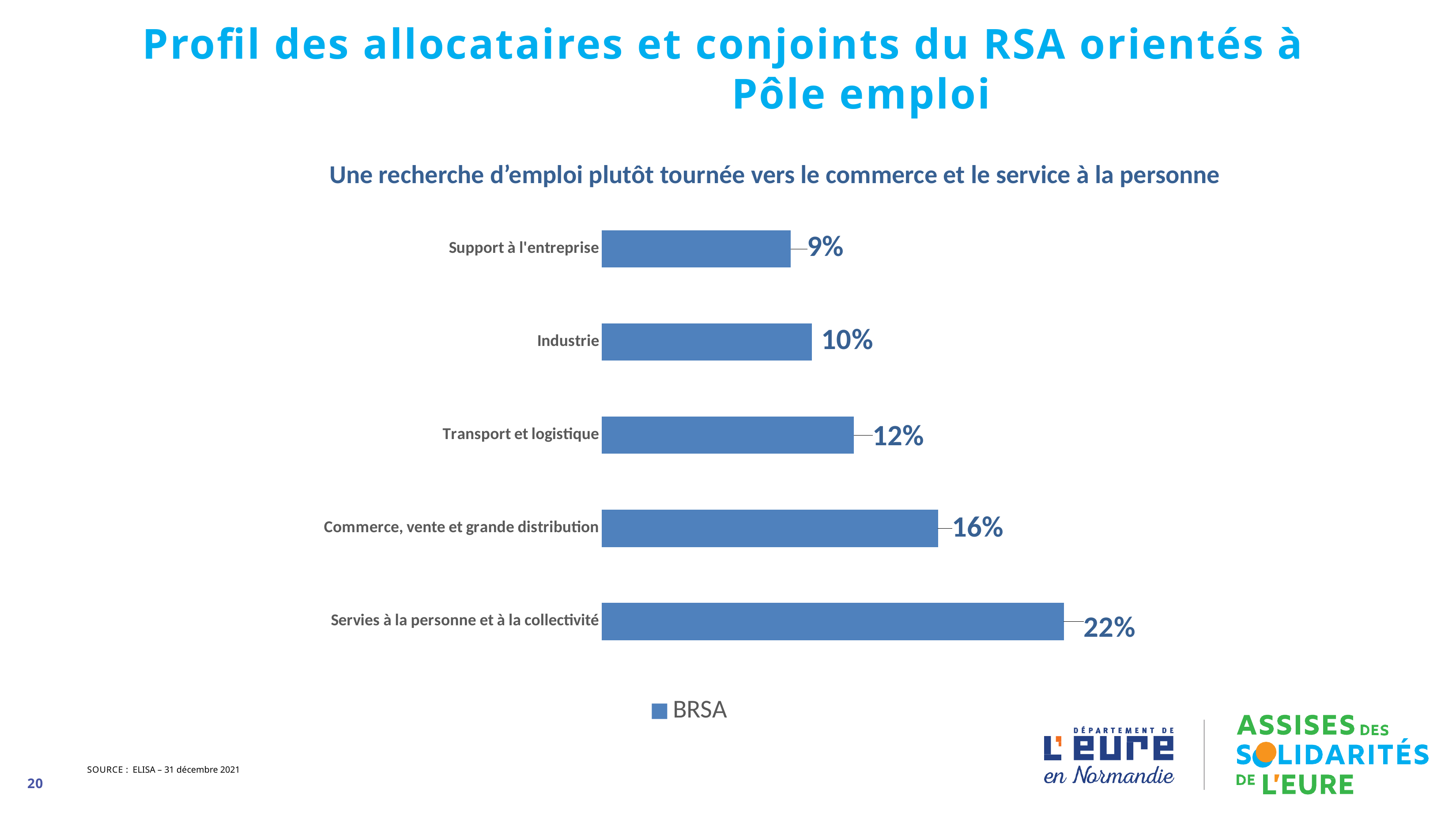
Which category has the highest value? Servies à la personne et à la collectivité What is the name of the series shown in the legend? BRSA What kind of chart is shown on the slide? Bar chart What is the difference between the values for Transport et logistique and Industrie? 2% How many categories are shown in the chart? 5 What is the value for Commerce, vente et grande distribution? 16% How many series does the legend list? 1 What is the difference between the values for Servies à la personne et à la collectivité and Commerce, vente et grande distribution? 6% Which is larger, the value for Transport et logistique or the value for Industrie? Transport et logistique What is the value for Support à l'entreprise? 9% Which category has the lowest value? Support à l'entreprise What is the value for Industrie? 10%